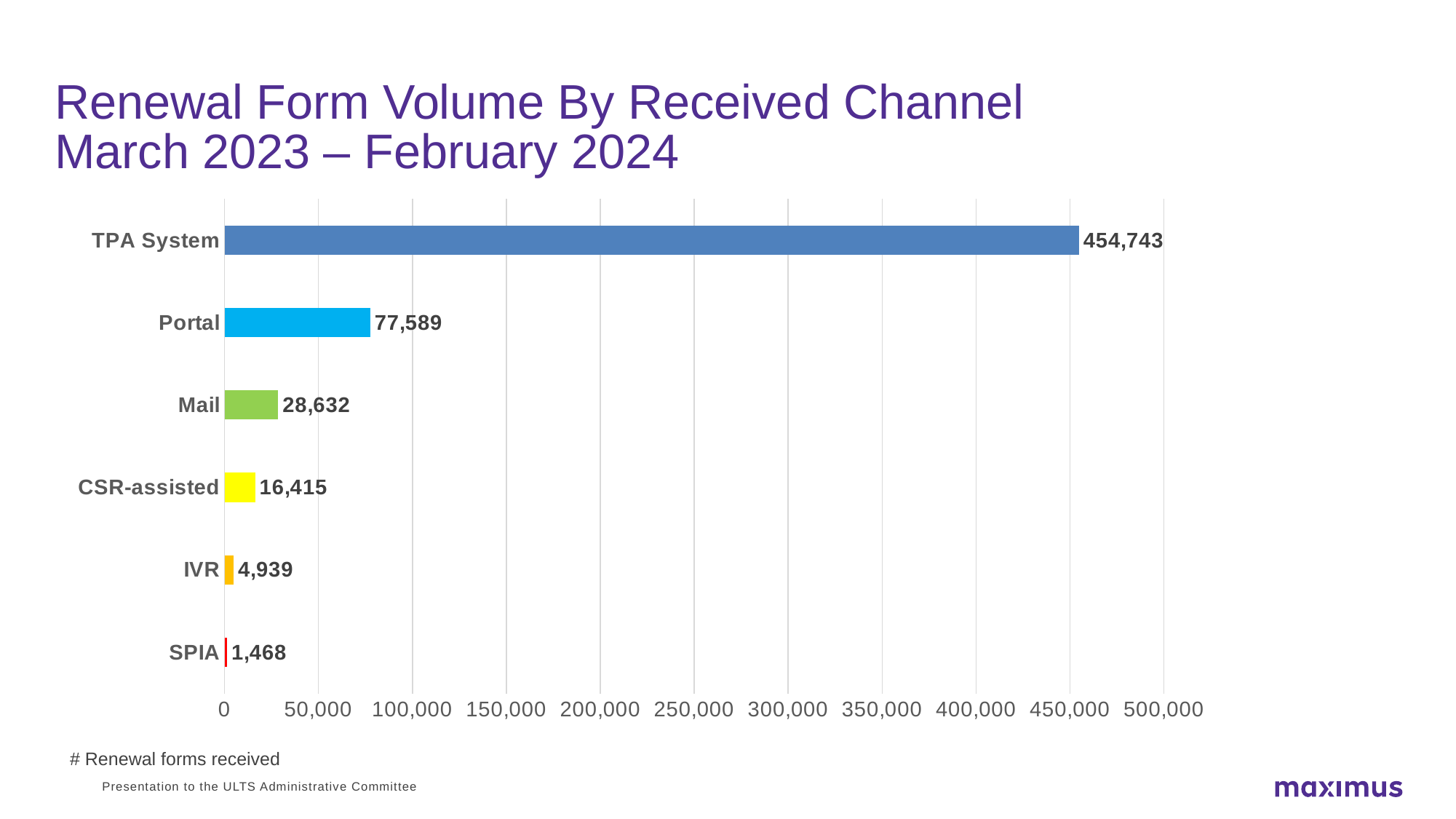
How many channels are shown in the chart? 6 What type of chart is shown on the slide? Bar chart What is the title of the chart on the slide? Renewal Form Volume By Received Channel March 2023 – February 2024 How many renewal forms were received by Mail? 28,632 Which channel received the fewest renewal forms? SPIA What is the value for the IVR channel? 4,939 What is the difference between the Portal and Mail values? 48,957 What is the value shown for the Portal channel? 77,589 Which channel has a larger value, Mail or CSR-assisted? Mail Which channel received the highest number of renewal forms? TPA System How many renewal forms were received through the TPA System? 454,743 What is the difference between the CSR-assisted and IVR values? 11,476